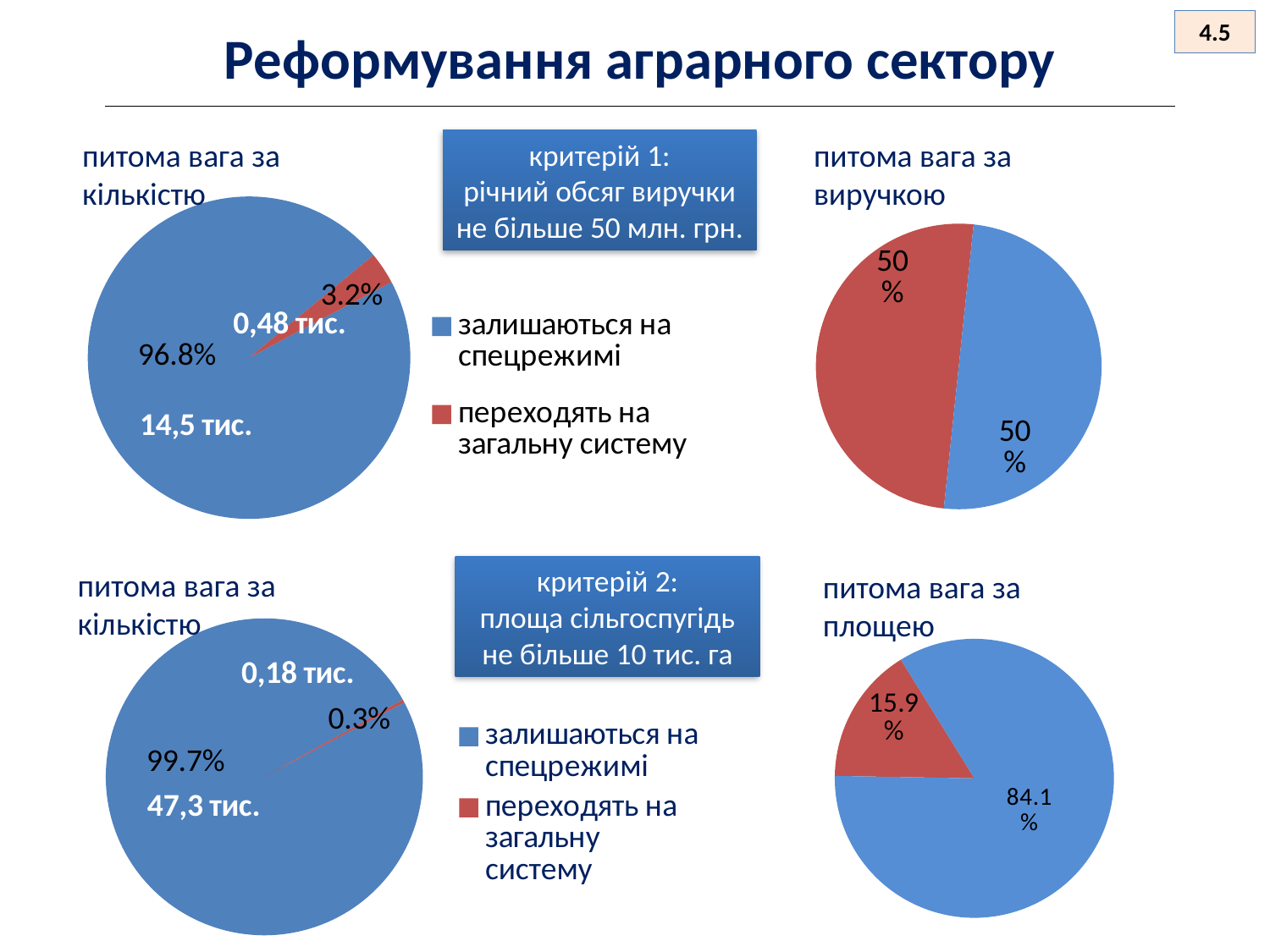
In the bottom-right pie chart titled 'питома вага за площею', what is the difference between the two slices' shares? 68.2% In the bottom-right pie chart titled 'питома вага за площею', what share is labelled for the blue slice? 84.1% In the top-right pie chart titled 'питома вага за виручкою', what share is shown for each of the two slices? 50% In the bottom-right pie chart titled 'питома вага за площею', which slice is larger: 'залишаються на спецрежимі' or 'переходять на загальну систему'? залишаються на спецрежимі In the top-left pie chart (питома вага за кількістю, критерій 1), what share is labelled for the red slice 'переходять на загальну систему'? 3.2% What type of chart is used for 'питома вага за виручкою'? pie chart How many entries does the legend next to the top-left pie chart list? 2 How many slices does the top-left pie chart (питома вага за кількістю, критерій 1) have? 2